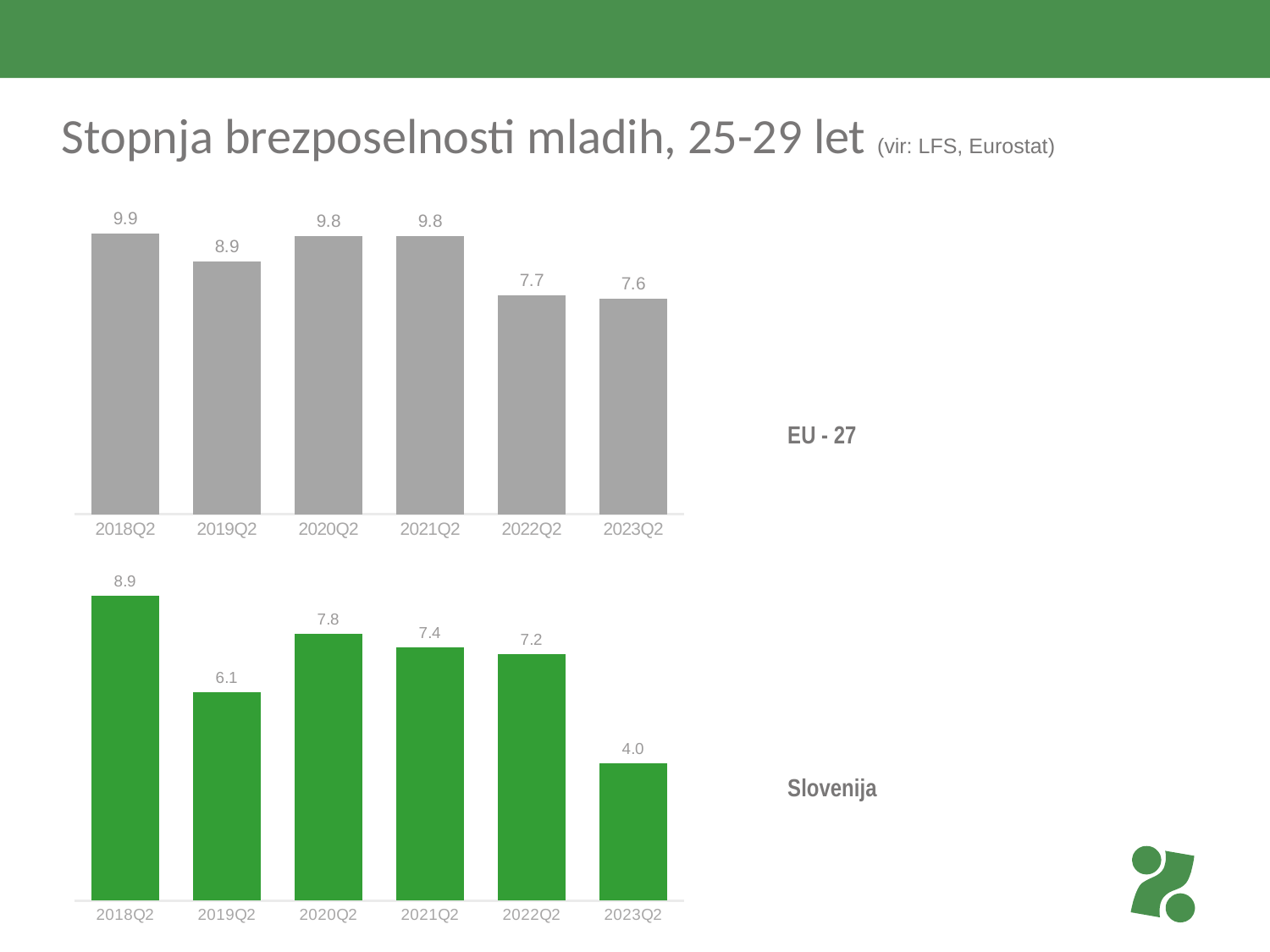
In the Slovenija chart, what is the value for 2021Q2? 7.4 In the Slovenija chart, what is the difference between the 2018Q2 and 2023Q2 values? 4.9 How many periods are shown on the x axis of the EU - 27 chart? 6 What kind of chart is the Slovenija chart? Bar chart In the EU - 27 chart, do the values generally rise or fall from 2021Q2 to 2023Q2? Fall In the EU - 27 chart, what is the difference between the 2018Q2 and 2019Q2 values? 1.0 In the Slovenija chart, which is larger, the value for 2019Q2 or the value for 2020Q2? 2020Q2 What colour are the bars in the Slovenija chart? Green In the EU - 27 chart, what is the value for 2018Q2? 9.9 In the EU - 27 chart, which period has the lowest value? 2023Q2 In the Slovenija chart, what is the value for 2023Q2? 4.0 In the Slovenija chart, which period has the highest value? 2018Q2